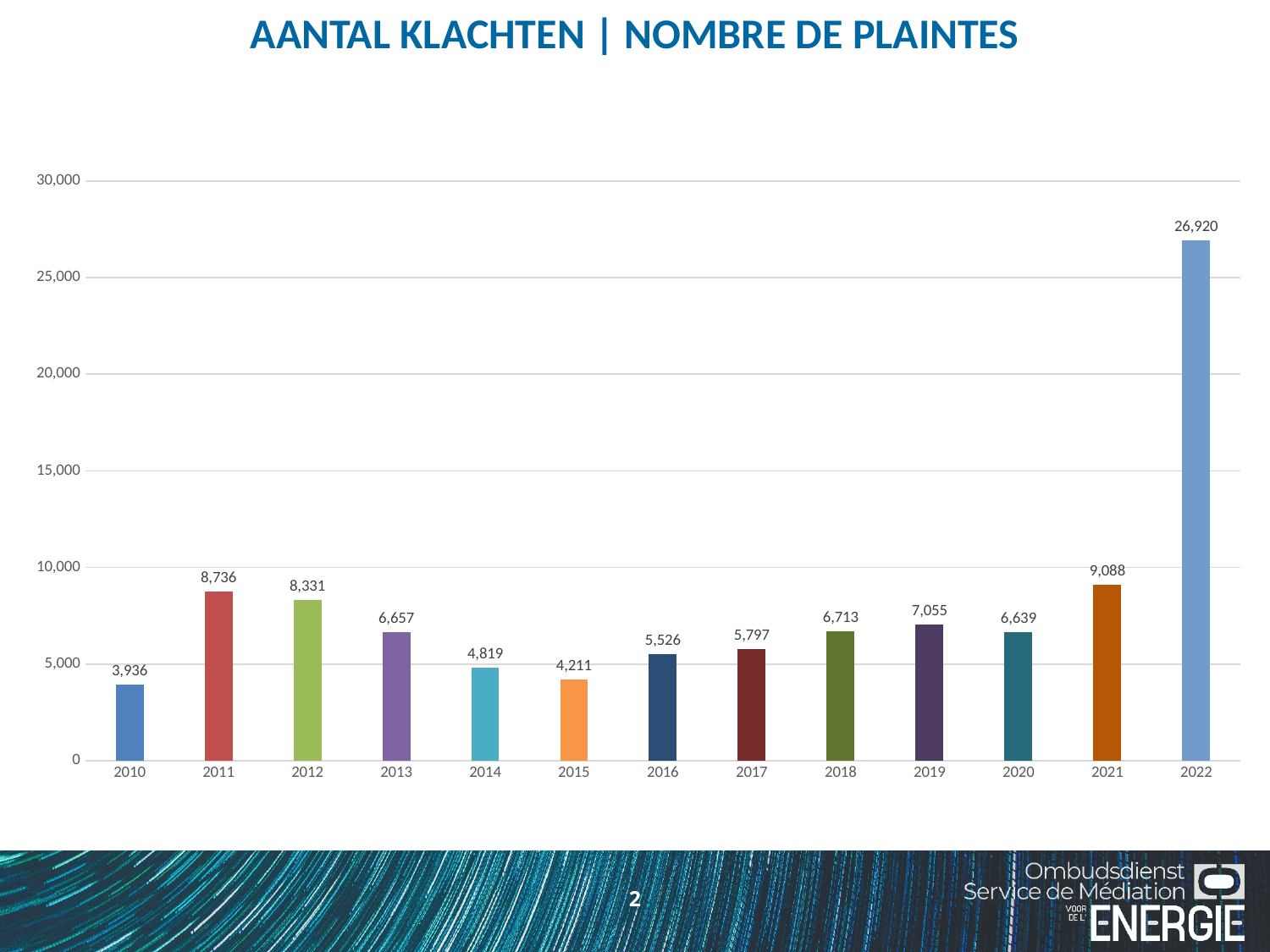
What is the difference between the values for 2022 and 2021? 17,832 Which year has the lowest number of complaints? 2010 What is the title of the chart? AANTAL KLACHTEN | NOMBRE DE PLAINTES Which is larger, the value for 2013 or the value for 2014? 2013 Which year has the highest number of complaints? 2022 How many years are shown on the x axis? 13 What is the value shown for 2015? 4,211 What kind of chart is shown on the slide? bar chart What is the number of complaints shown for 2022? 26,920 What is the value shown for 2010? 3,936 What is the difference between the values for 2011 and 2012? 405 Is the value for 2021 greater or less than 10,000? less